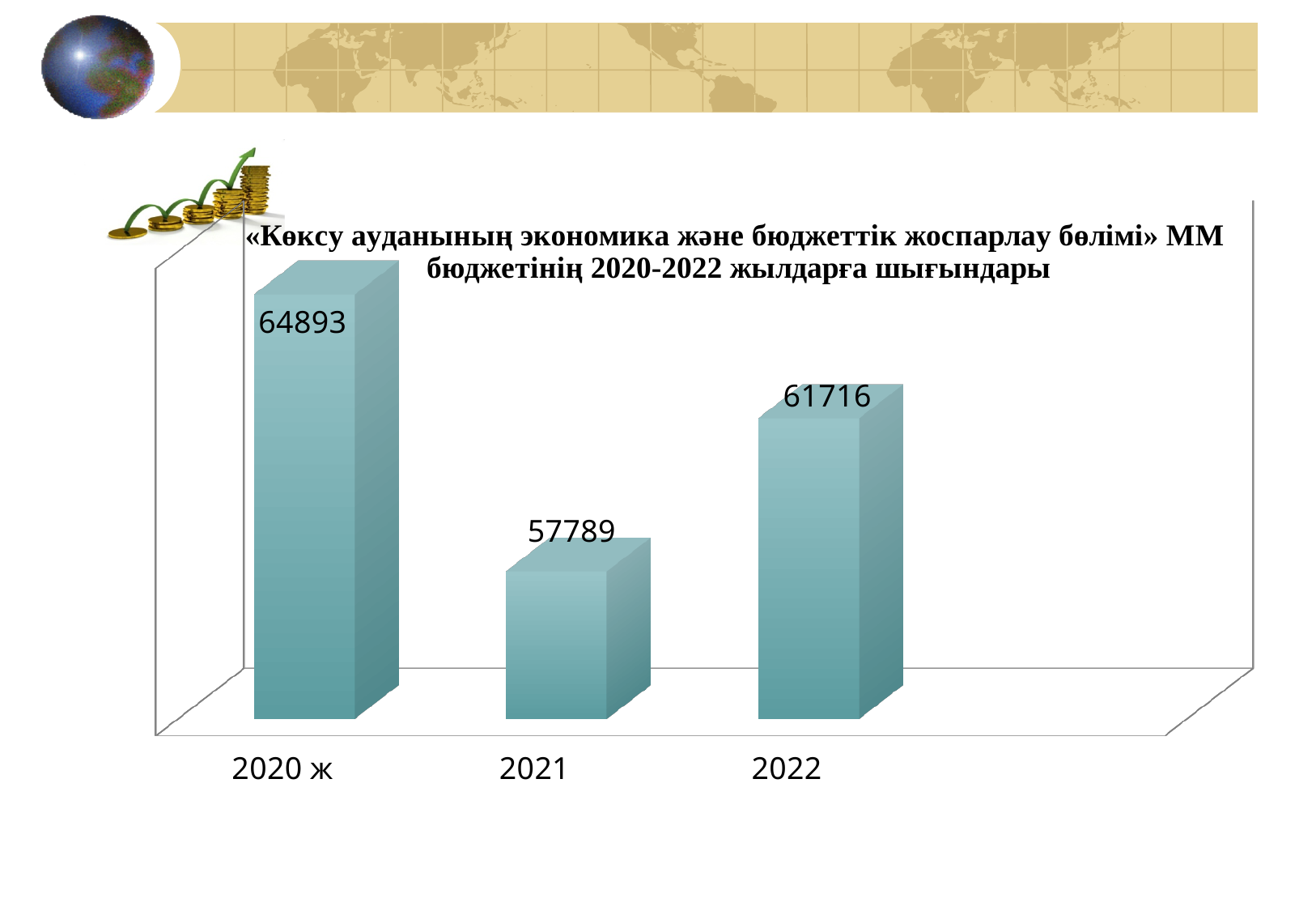
What is the value shown for 2022? 61716 How many years (categories) are shown in the chart? 3 What is the difference between the values for 2022 and 2021? 3927 What kind of chart is shown on the slide? bar chart What is the value shown for 2020 ж? 64893 What is the difference between the values for 2020 ж and 2022? 3177 What is the value shown for 2021? 57789 What is the difference between the values for 2020 ж and 2021? 7104 Which is larger, the value for 2021 or the value for 2022? 2022 Which year has the lowest value? 2021 Which year has the highest value? 2020 ж Does the value rise or fall from 2020 ж to 2021? fall